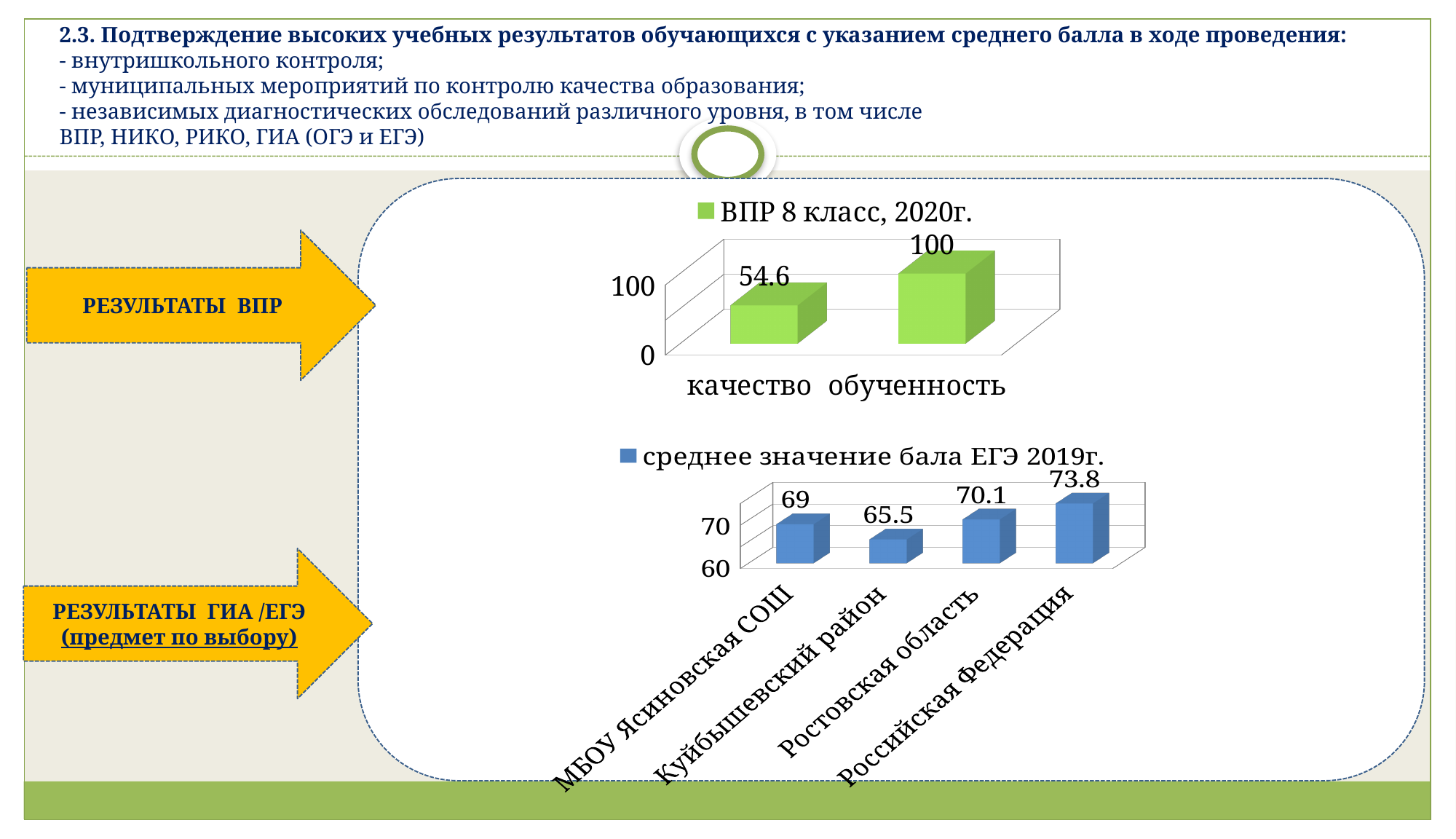
In the bottom chart (среднее значение бала ЕГЭ 2019г.), which category has the lowest value? Куйбышевский район In the top chart (ВПР 8 класс, 2020г.), what is the value for обученность? 100 In the bottom chart (среднее значение бала ЕГЭ 2019г.), which category has the highest value? Российская Федерация In the bottom chart (среднее значение бала ЕГЭ 2019г.), what is the value for Куйбышевский район? 65.5 In the bottom chart (среднее значение бала ЕГЭ 2019г.), what is the difference between Российская Федерация and МБОУ Ясиновская СОШ? 4.8 In the top chart (ВПР 8 класс, 2020г.), what is the value for качество? 54.6 In the top chart (ВПР 8 класс, 2020г.), how many categories are shown? 2 In the bottom chart (среднее значение бала ЕГЭ 2019г.), what is the value for Российская Федерация? 73.8 In the bottom chart (среднее значение бала ЕГЭ 2019г.), which is larger: Ростовская область or МБОУ Ясиновская СОШ? Ростовская область What type of chart is the bottom chart (среднее значение бала ЕГЭ 2019г.)? Bar chart In the top chart (ВПР 8 класс, 2020г.), what is the difference between обученность and качество? 45.4 In the bottom chart (среднее значение бала ЕГЭ 2019г.), what is the value for МБОУ Ясиновская СОШ? 69